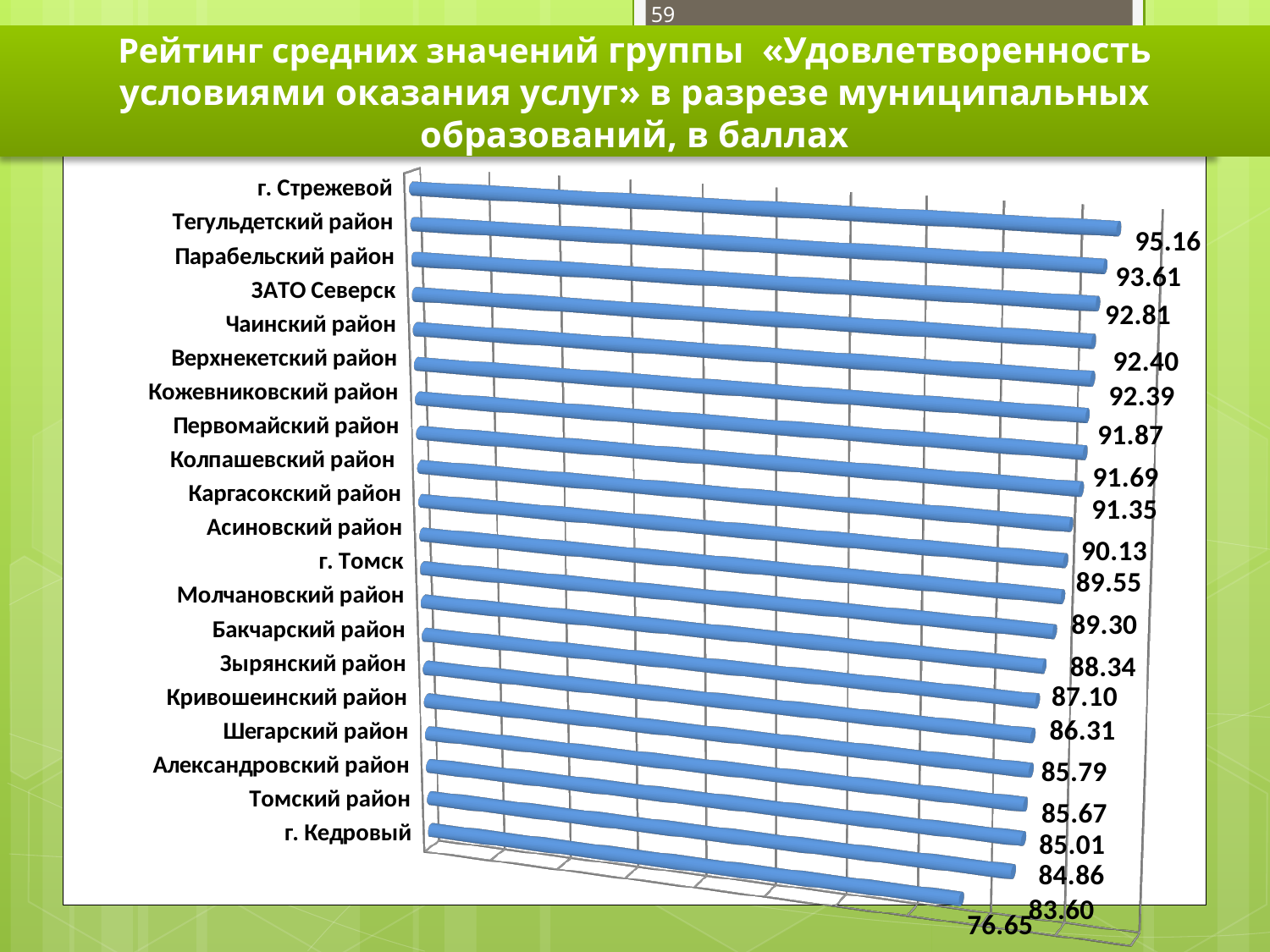
What is the value for Томский район? 83.60 Which municipality has the lowest value on the chart? г. Кедровый What is the value for г. Стрежевой? 95.16 Do the values rise or fall going down the list from г. Стрежевой to г. Кедровый? fall What is the value for г. Кедровый? 76.65 What type of chart is shown on the slide? bar chart Which municipality has the highest value on the chart? г. Стрежевой How many municipalities are listed on the chart? 20 Which has a larger value, Колпашевский район or Молчановский район? Колпашевский район What is the value for г. Томск? 88.34 What is the value for Тегульдетский район? 93.61 What is the difference between the values for г. Стрежевой and г. Кедровый? 18.51